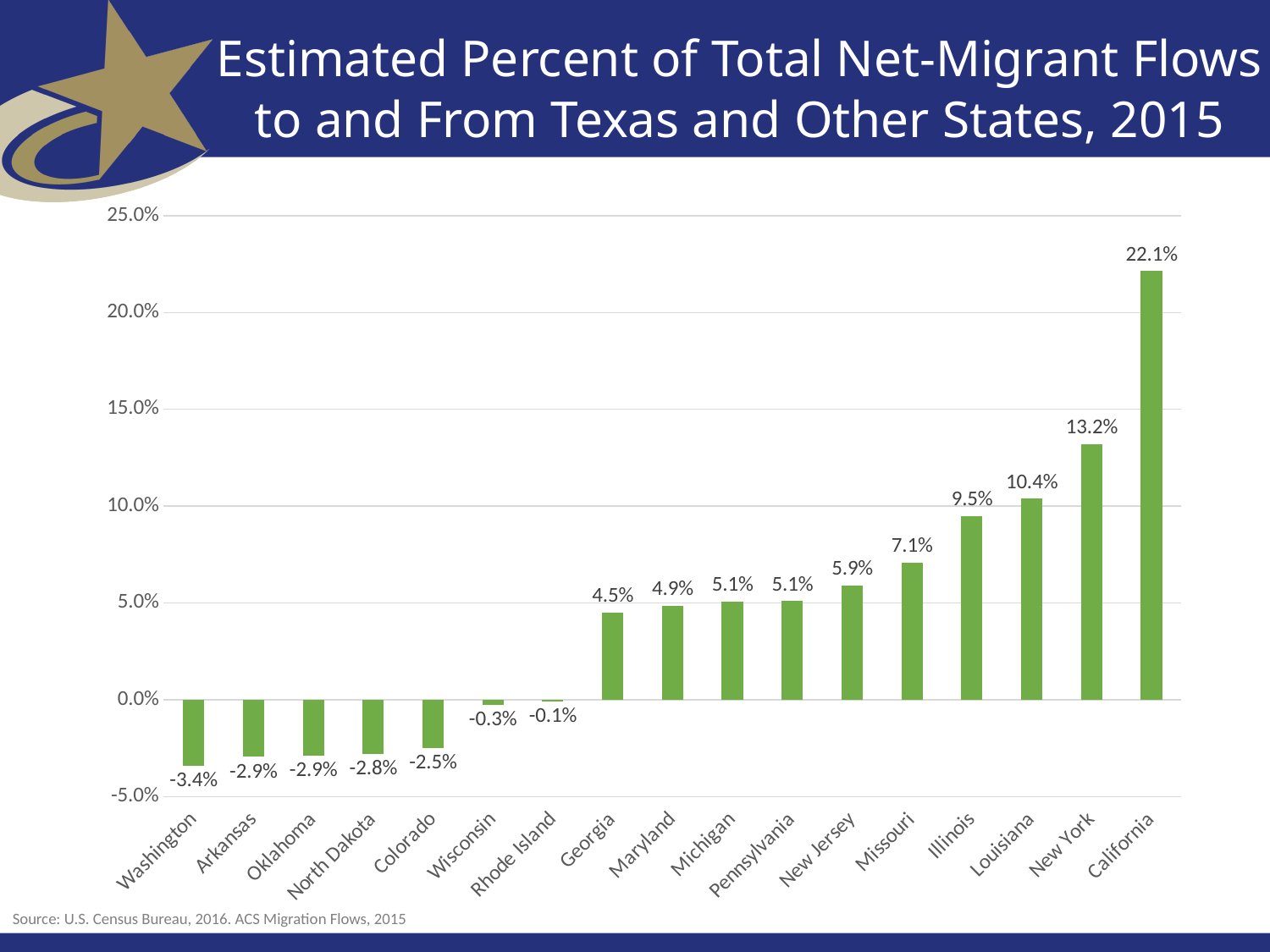
What kind of chart is this? Bar chart Do the values rise or fall from left to right along the x axis? Rise Which is larger, the value for Illinois or the value for Louisiana? Louisiana Which state has the highest value? California What is the value for Washington? -3.4% What is the value for California? 22.1% Is the value for New York greater or less than 10.0%? greater What is the value for Missouri? 7.1% What is the difference between the values for California and New York? 8.9% Which state has the lowest value? Washington What is the title of the chart? Estimated Percent of Total Net-Migrant Flows to and From Texas and Other States, 2015 How many states are shown on the chart? 17